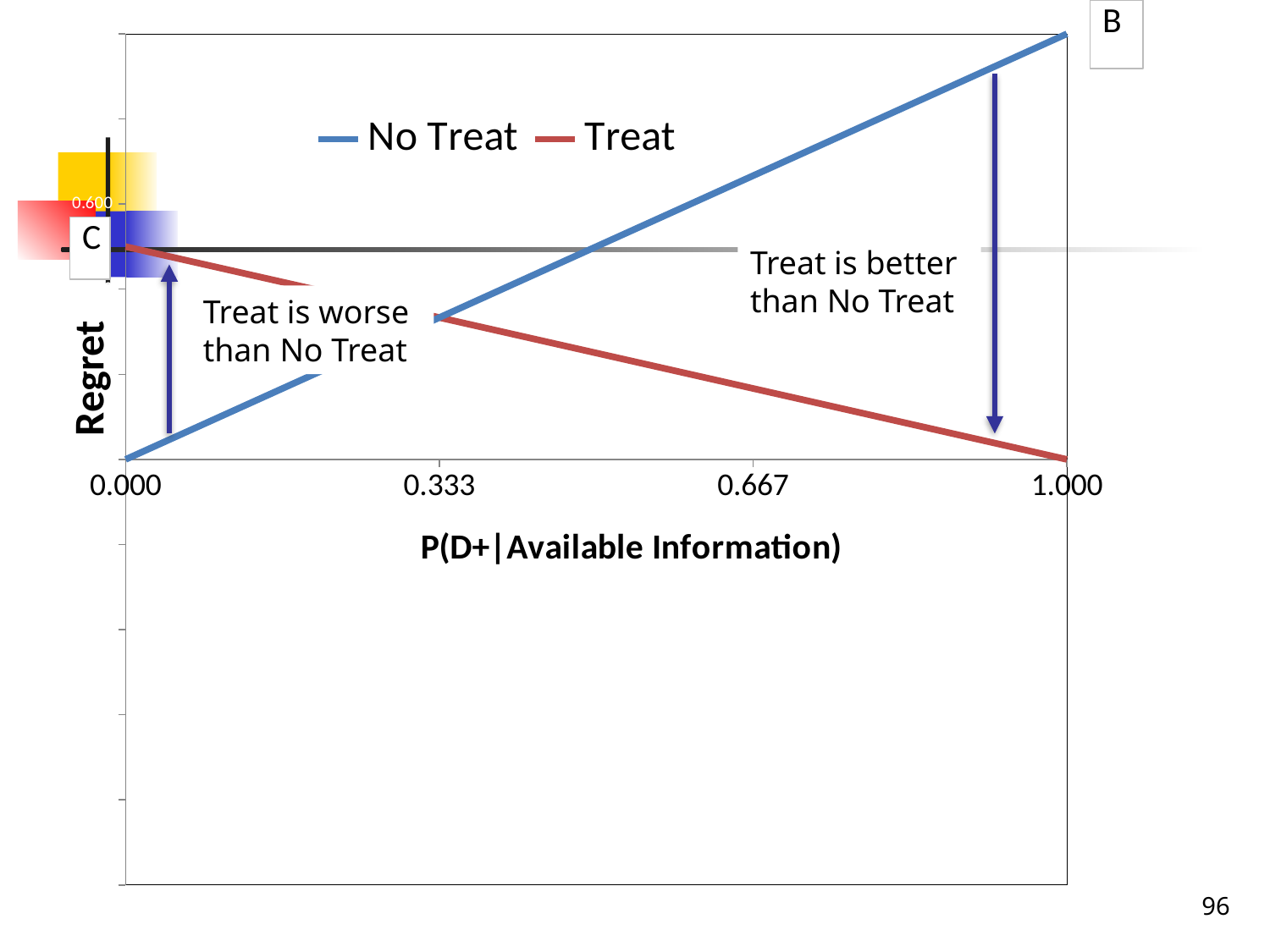
At P(D+|Available Information) = 1.000, which series has the higher regret, No Treat or Treat? No Treat Does the No Treat line rise or fall as P(D+|Available Information) increases from 0.000 to 1.000? rise What are the two series named in the legend? No Treat and Treat What is the largest value labelled on the x axis? 1.000 Which series reaches the highest regret anywhere on the chart? No Treat How many series does the legend list? 2 What is the smallest value labelled on the x axis? 0.000 At P(D+|Available Information) = 0.000, which series has the higher regret, No Treat or Treat? Treat Does the Treat line rise or fall as P(D+|Available Information) increases from 0.000 to 1.000? fall What is the title of the x axis? P(D+|Available Information) How many tick labels are shown on the x axis? 4 What kind of chart is shown on the slide? line chart